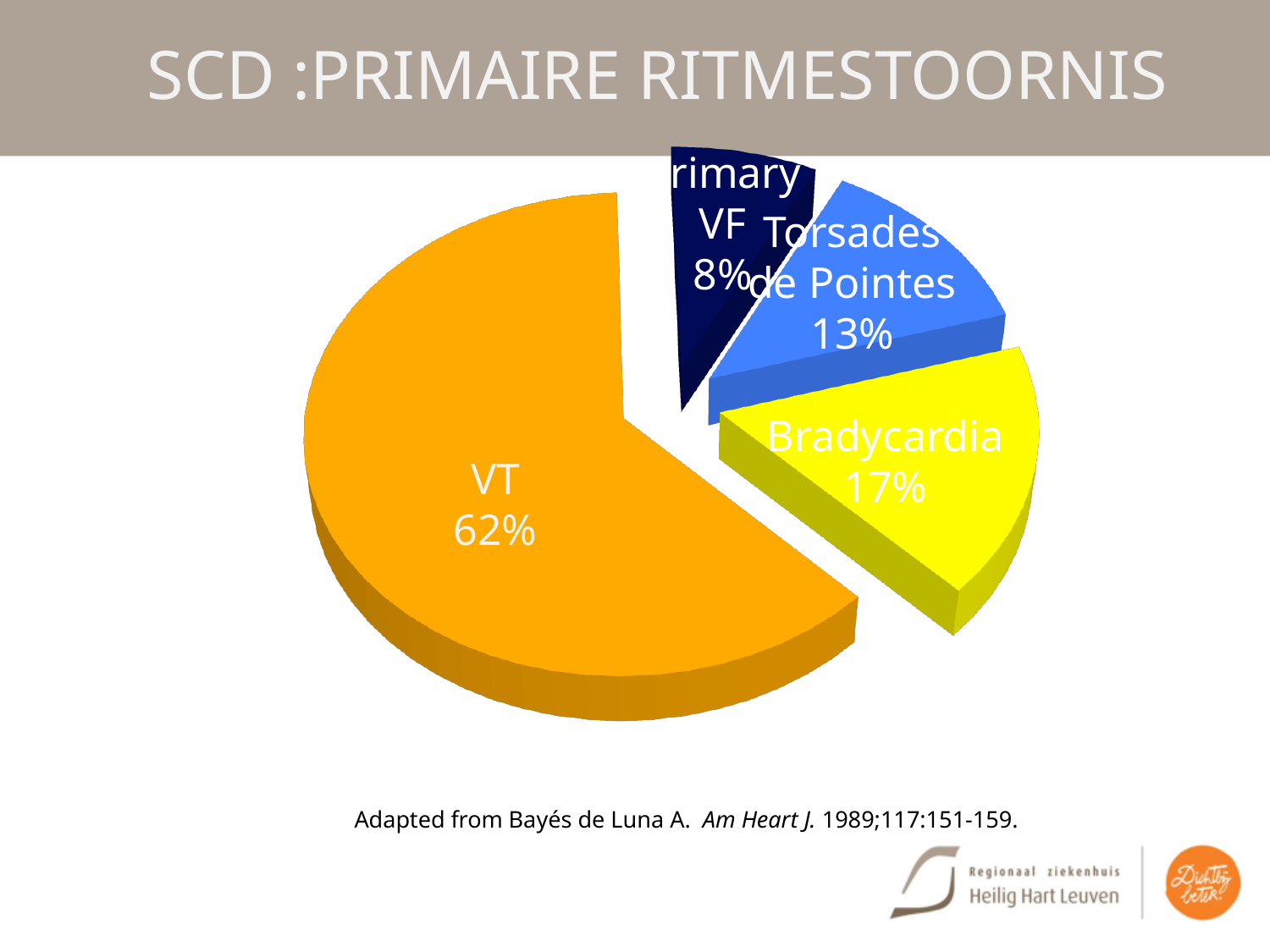
Which is larger, the share for Bradycardia or the share for Torsades de Pointes? Bradycardia What is the title of the slide? SCD :PRIMAIRE RITMESTOORNIS What is the difference in percentage points between VT and Bradycardia? 45 How many slices does the pie chart have? 4 What percentage of the pie chart is Primary VF? 8% Which category has the largest share of the pie chart? VT What percentage of the pie chart is Bradycardia? 17% What colour is the VT slice of the pie chart? Orange What percentage of the pie chart is VT? 62% What percentage of the pie chart is Torsades de Pointes? 13% What kind of chart is shown on the slide? Pie chart Which category has the smallest share of the pie chart? Primary VF